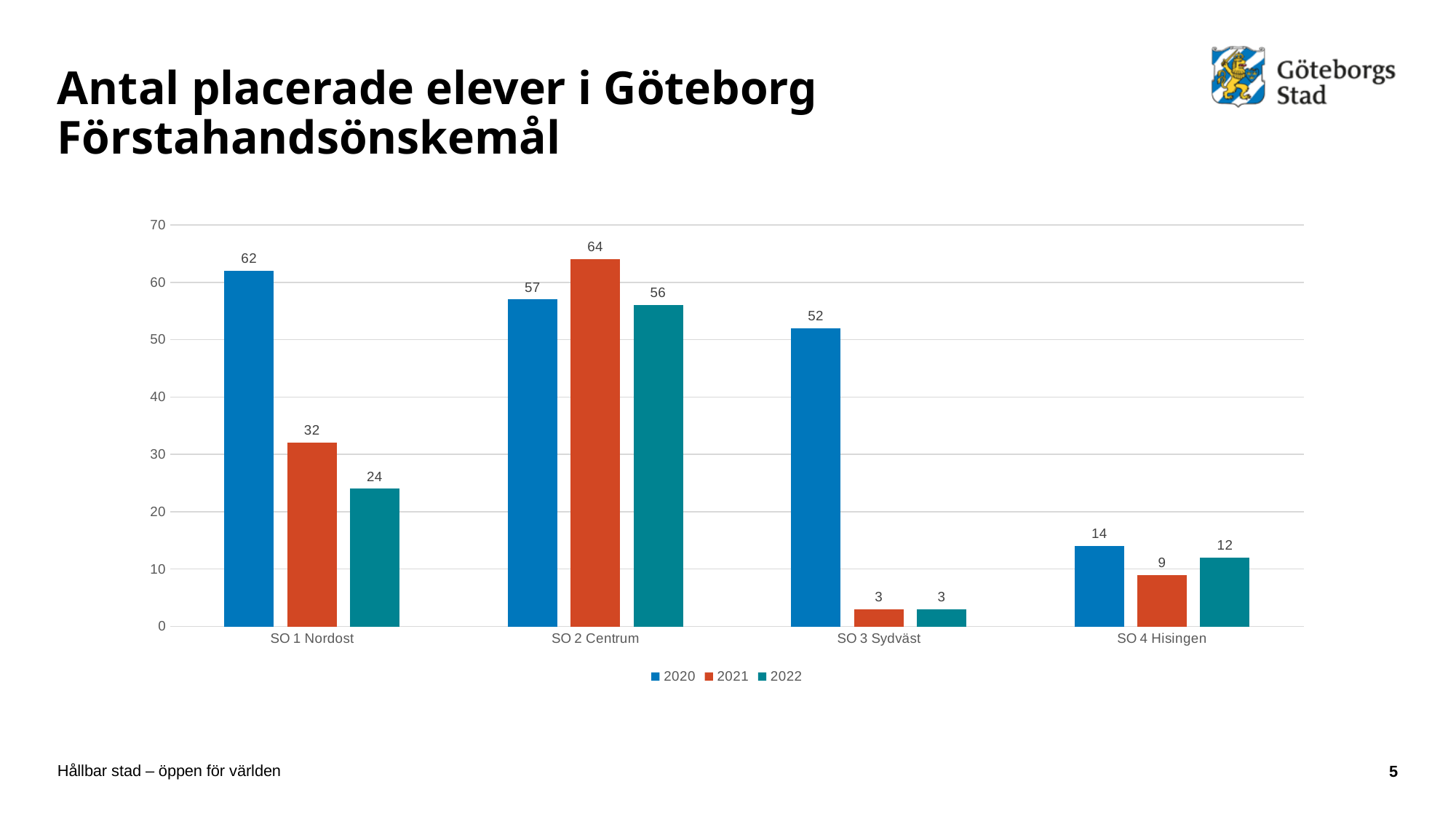
How many categories are shown on the x axis? 4 What kind of chart is shown on the slide? Bar chart What is the value for SO 1 Nordost in 2020? 62 Is the value for SO 3 Sydväst in 2020 greater or less than 50? greater Do the values for SO 1 Nordost rise or fall from 2020 to 2022? Fall What is the value for SO 4 Hisingen in 2022? 12 How many series does the legend list? 3 What is the value for SO 3 Sydväst in 2021? 3 Which is larger for SO 2 Centrum: the 2021 value or the 2022 value? 2021 What is the difference between the 2020 and 2022 values for SO 1 Nordost? 38 Which category has the highest value in the 2021 series? SO 2 Centrum Which category has the lowest value in the 2020 series? SO 4 Hisingen